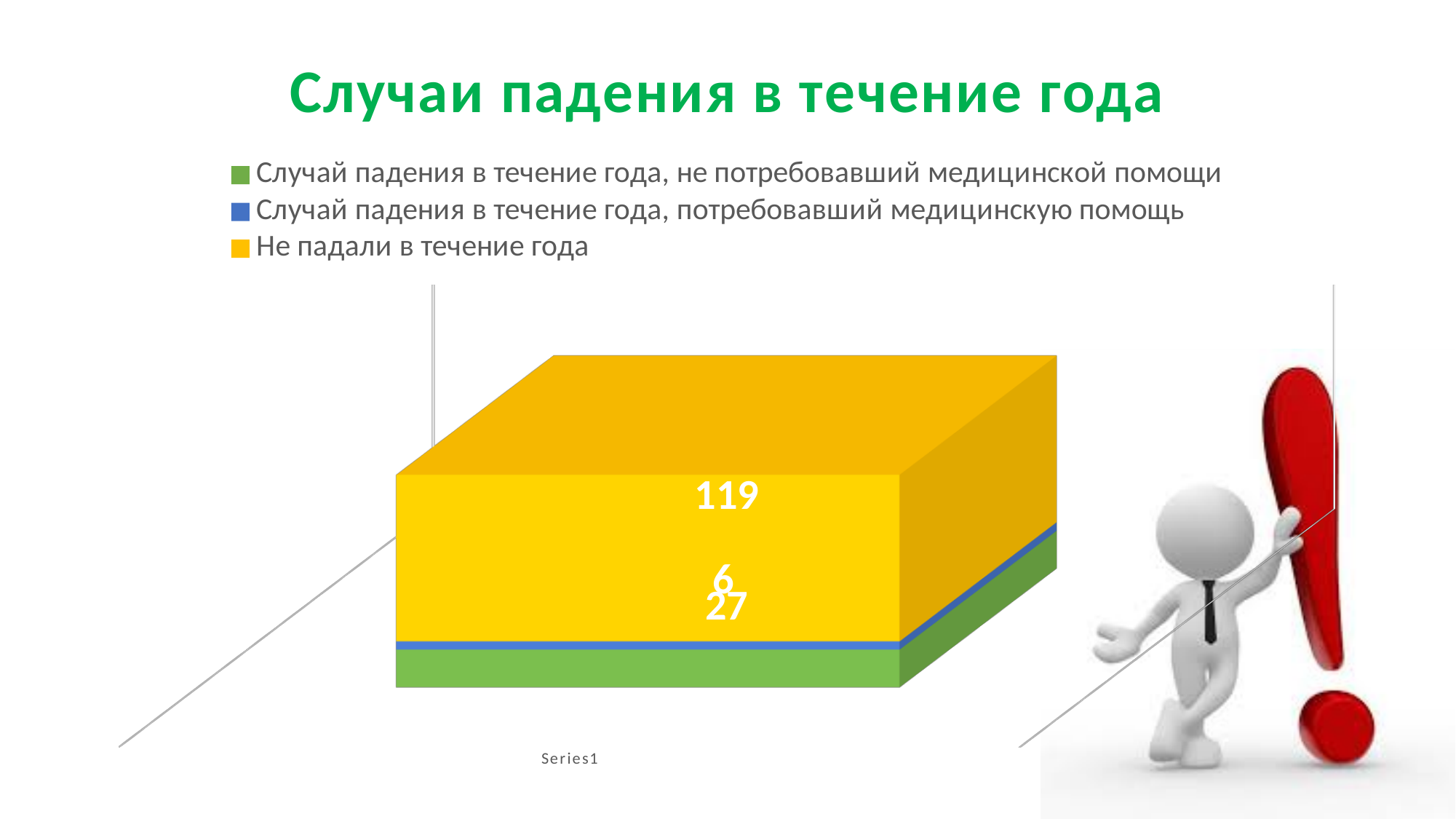
What is the difference between the value for "Не падали в течение года" and the value for "Случай падения в течение года, не потребовавший медицинской помощи"? 92 What is the value for "Не падали в течение года"? 119 Which series has the lowest value? Случай падения в течение года, потребовавший медицинскую помощь What is the title of the slide's chart? Случаи падения в течение года What is the total of the stacked bar? 152 What kind of chart is shown on the slide? Stacked bar chart How many series does the legend list? 3 Which is larger: the value for falls not requiring medical help or the value for falls requiring medical help? Случай падения в течение года, не потребовавший медицинской помощи Which series has the highest value? Не падали в течение года What is the value for "Случай падения в течение года, не потребовавший медицинской помощи"? 27 What is the difference between the values for falls not requiring medical help and falls requiring medical help? 21 What is the value for "Случай падения в течение года, потребовавший медицинскую помощь"? 6